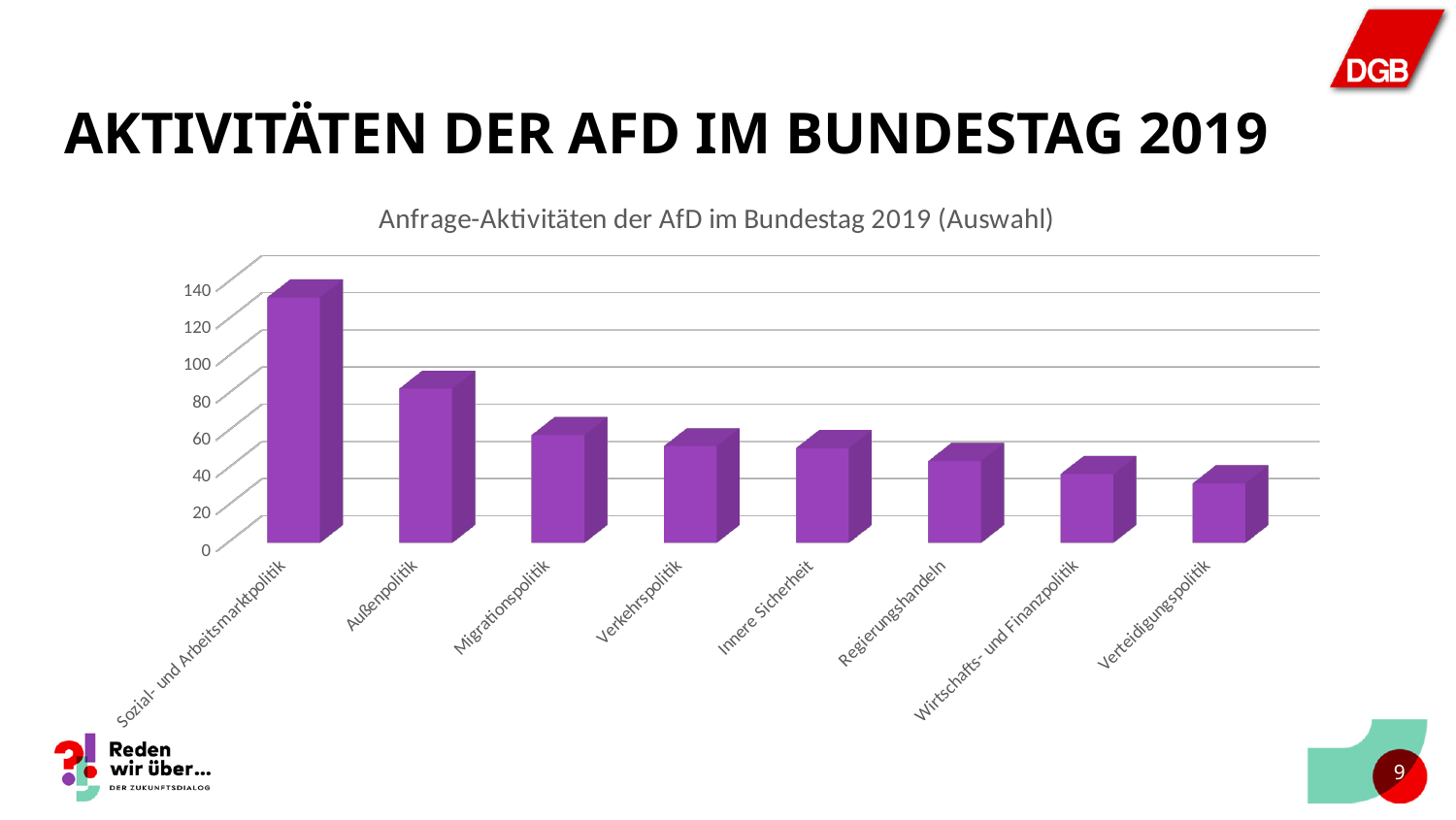
Is the value for Verteidigungspolitik greater or less than 60? less Which category has the highest value? Sozial- und Arbeitsmarktpolitik What is the title of the chart? Anfrage-Aktivitäten der AfD im Bundestag 2019 (Auswahl) Do the values rise or fall from left to right along the x axis? fall How many categories are plotted in the chart? 8 Which is larger, the value for Außenpolitik or the value for Migrationspolitik? Außenpolitik What kind of chart is shown on the slide? bar chart Which is larger, the value for Regierungshandeln or the value for Verteidigungspolitik? Regierungshandeln Is the value for Migrationspolitik greater or less than 80? less Is the value for Sozial- und Arbeitsmarktpolitik greater or less than 120? greater Which category has the lowest value? Verteidigungspolitik